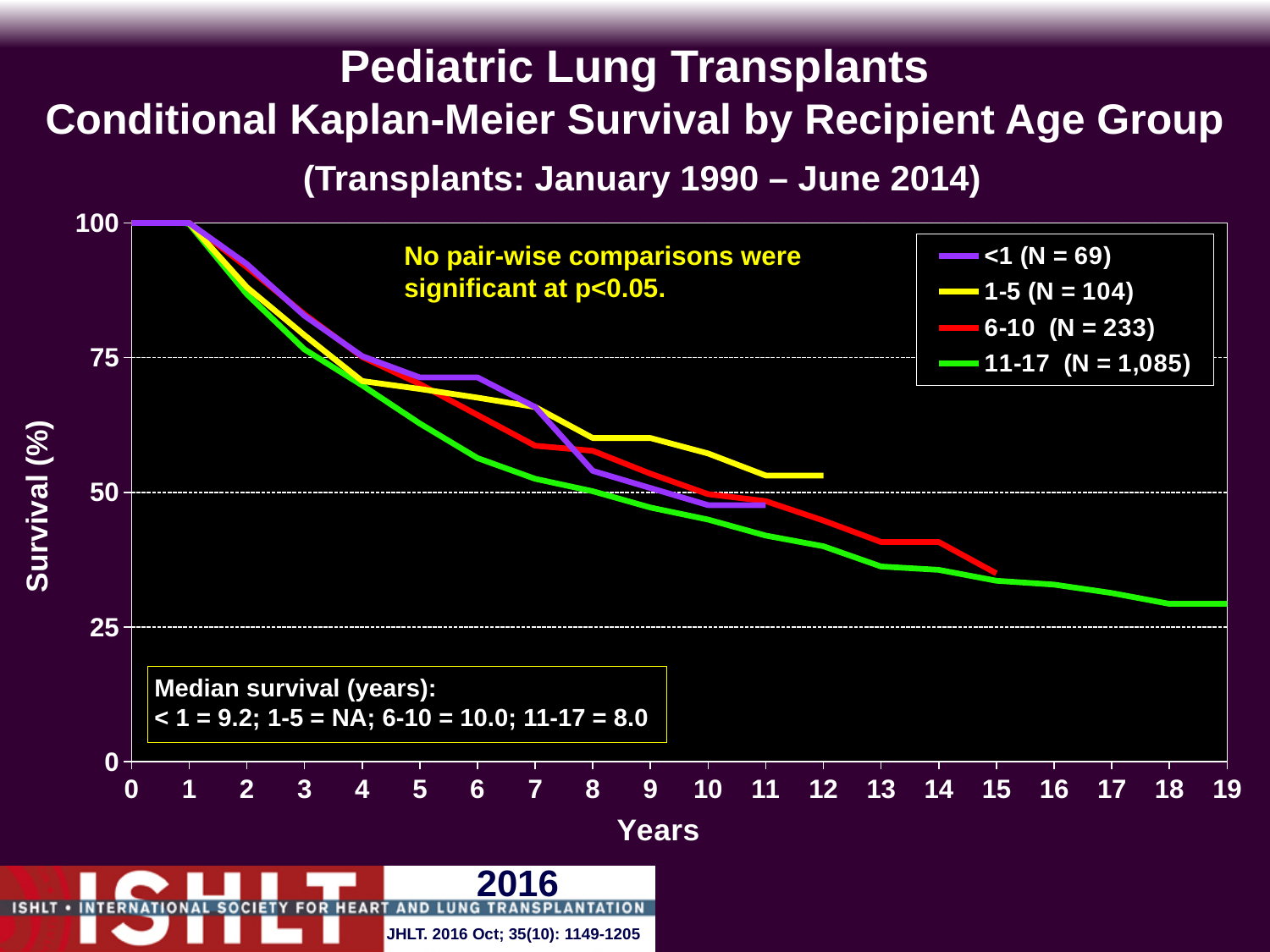
At 9 years, which group has higher survival: 1-5 or 11-17? 1-5 What is the median survival in years for the 6-10 age group? 10.0 Is the survival value for the 6-10 group at 15 years greater or less than 50? less How many recipient age groups (series) does the legend list? 4 What is the median survival listed for the 1-5 age group? NA What is the N for the 11-17 recipient age group shown in the legend? 1,085 Among the groups with a numeric median survival, which has the lowest median survival? 11-17 (8.0 years) Which age group has the largest number of recipients (N) in the legend? 11-17 (N = 1,085) Is the survival value for the 11-17 group at 19 years greater or less than 25? greater Which age group has the smallest number of recipients (N) in the legend? <1 (N = 69) What kind of chart is shown on the slide? Line chart Do the survival curves rise or fall as years since transplant increase? Fall